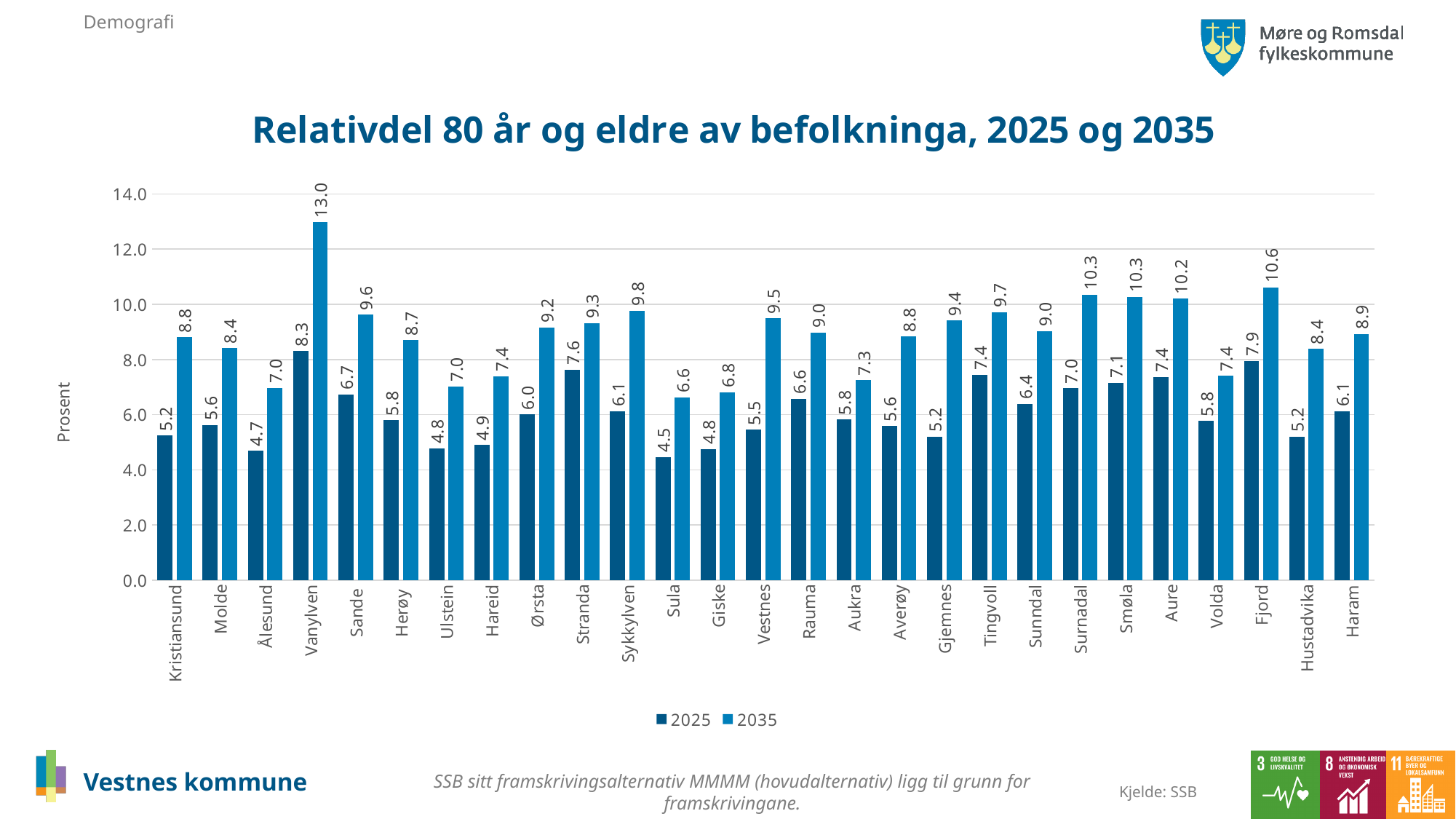
What is the label on the y axis? Prosent What is the value for Vanylven in 2025? 8.3 Which municipality has the lowest value in 2025? Sula How many municipalities are shown on the x axis? 27 Is the 2035 value for Vanylven greater or less than 12.0? greater What is the title of the chart? Relativdel 80 år og eldre av befolkninga, 2025 og 2035 What kind of chart is shown on the slide? bar chart What is the value for Vestnes in 2035? 9.5 What is the difference between the 2035 and 2025 values for Vestnes? 4.0 Which is larger, the 2035 value for Fjord or the 2035 value for Surnadal? Fjord Which municipality has the highest value in 2035? Vanylven How many series does the legend list? 2